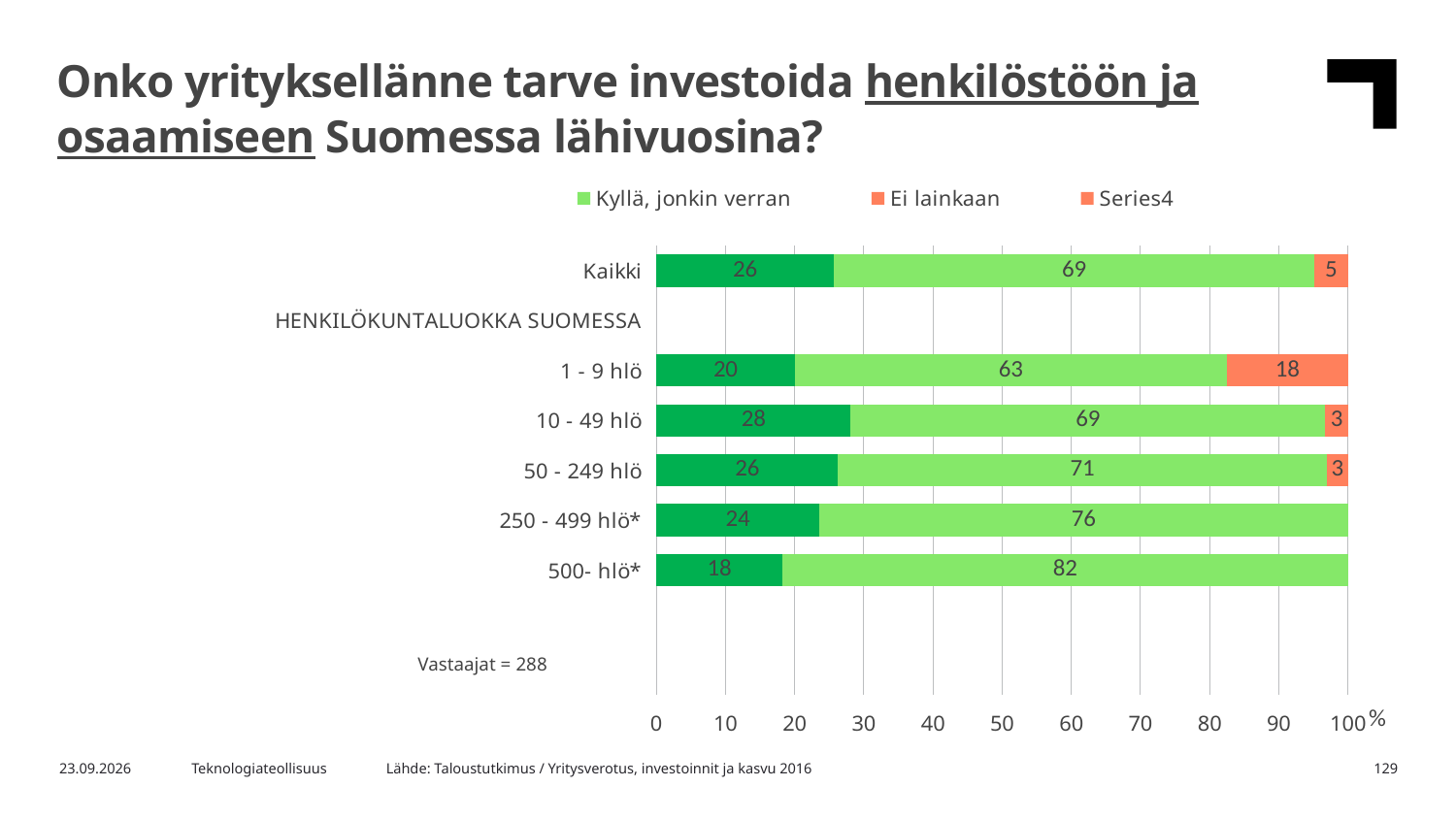
What is the value of the "Kyllä, jonkin verran" (light green) segment for Kaikki? 69 How many series does the legend list? 3 How many bars are plotted in the chart? 6 Which has a larger "Kyllä, jonkin verran" value: 50 - 249 hlö or 10 - 49 hlö? 50 - 249 hlö Which category has the highest "Kyllä, jonkin verran" (light green) value? 500- hlö* What is the difference between the "Kyllä, jonkin verran" values for 500- hlö* and 250 - 499 hlö*? 6 What is the value of the orange segment for the 1 - 9 hlö category? 18 Which category has the largest dark green (first) segment? 10 - 49 hlö Which category has the lowest "Kyllä, jonkin verran" (light green) value? 1 - 9 hlö What is the value of the dark green (first) segment for the 250 - 499 hlö* category? 24 Which category has the smallest dark green (first) segment? 500- hlö* What type of chart is shown on the slide? Stacked bar chart